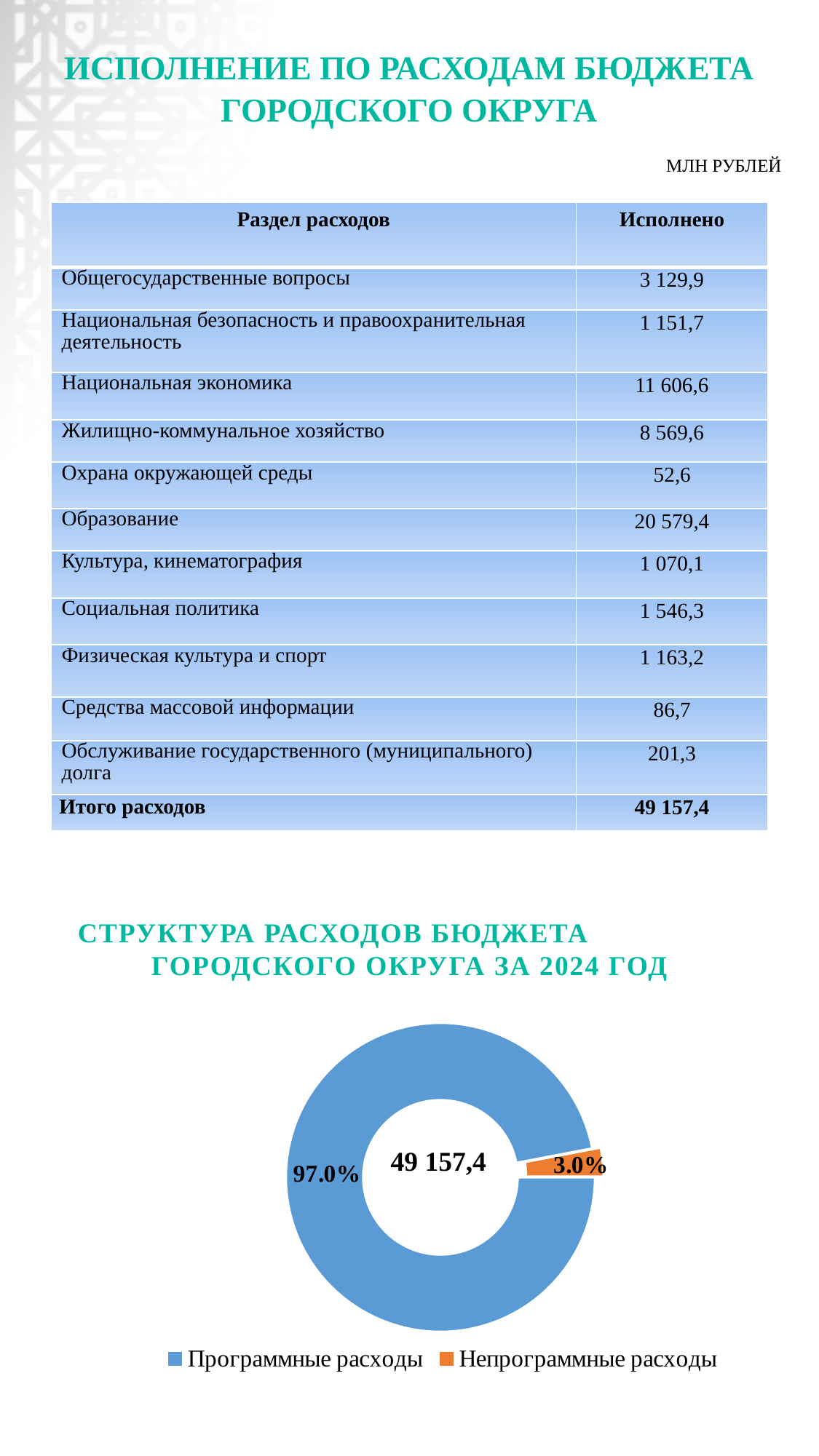
In the doughnut chart, what share is labelled for Программные расходы? 97.0% What is the title of the doughnut chart? Структура расходов бюджета городского округа за 2024 год How many categories does the legend of the doughnut chart list? 2 What is the difference in percentage points between the Программные расходы and Непрограммные расходы slices in the doughnut chart? 94.0 percentage points What colour is the Непрограммные расходы slice in the doughnut chart? orange What kind of chart is shown under the title "Структура расходов бюджета городского округа за 2024 год"? doughnut (pie) chart Which is larger in the doughnut chart: Программные расходы or Непрограммные расходы? Программные расходы Which category has the largest slice in the doughnut chart? Программные расходы How many slices does the doughnut chart have? 2 Which category has the smallest slice in the doughnut chart? Непрограммные расходы What value is printed in the centre of the doughnut chart? 49 157,4 In the doughnut chart, what share is labelled for Непрограммные расходы? 3.0%